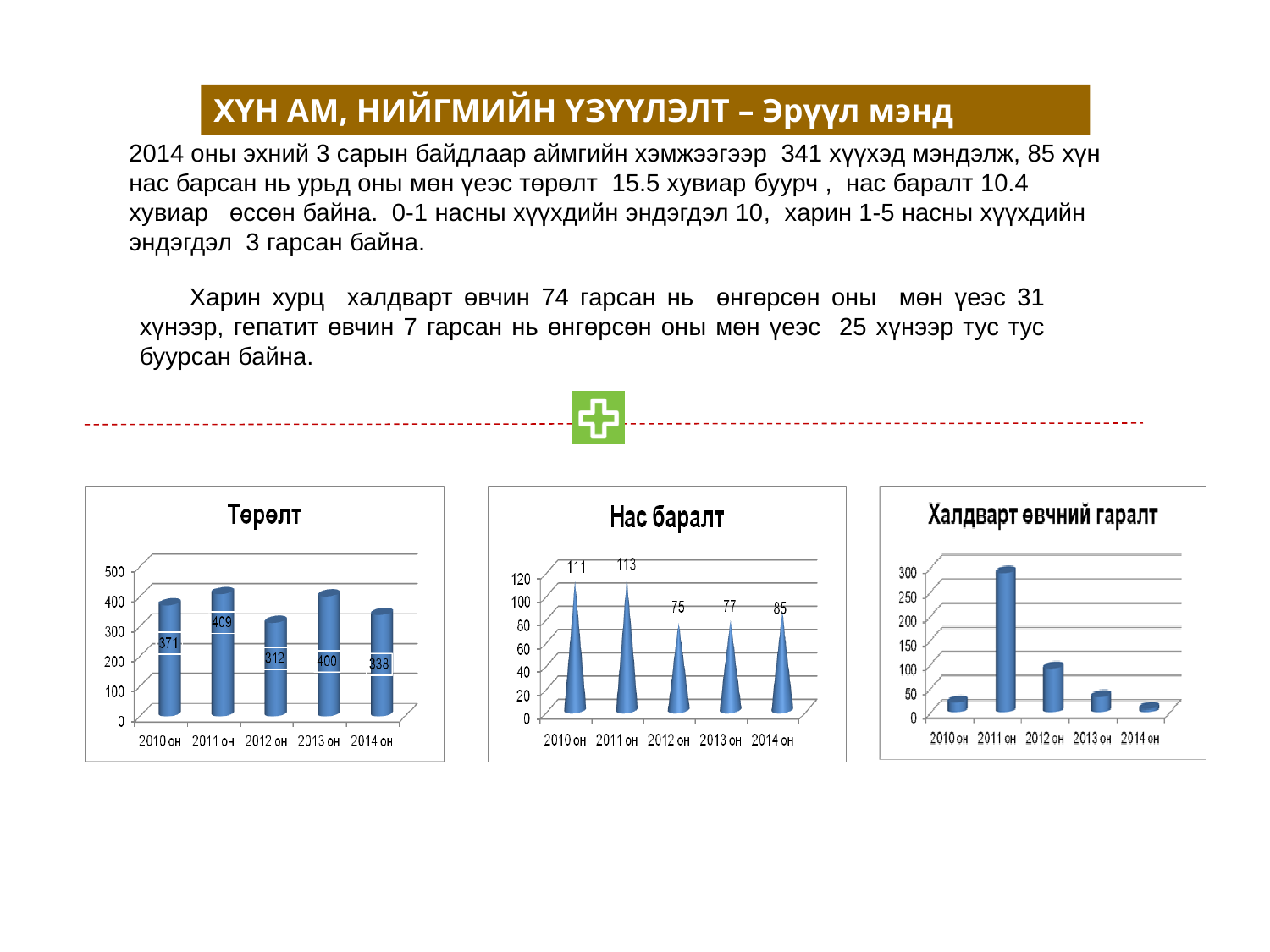
In the "Халдварт өвчний гаралт" chart, is the value for 2012 он greater or less than 50? greater In the "Нас баралт" chart, which year has the highest value? 2011 он In the "Төрөлт" chart, what is the difference between the values for 2011 он and 2012 он? 97 In the "Нас баралт" chart, what is the difference between the values for 2010 он and 2014 он? 26 In the "Төрөлт" chart, which year has the lowest value? 2012 он In the "Халдварт өвчний гаралт" chart, is the value for 2014 он greater or less than 50? less In the "Халдварт өвчний гаралт" chart, which year has the highest value? 2011 он In the "Нас баралт" chart, what is the value for 2012 он? 75 What kind of chart is the "Төрөлт" chart? bar chart In the "Нас баралт" chart, how many years are shown on the x axis? 5 In the "Төрөлт" chart, what is the value for 2014 он? 338 In the "Төрөлт" chart, what is the value for 2011 он? 409